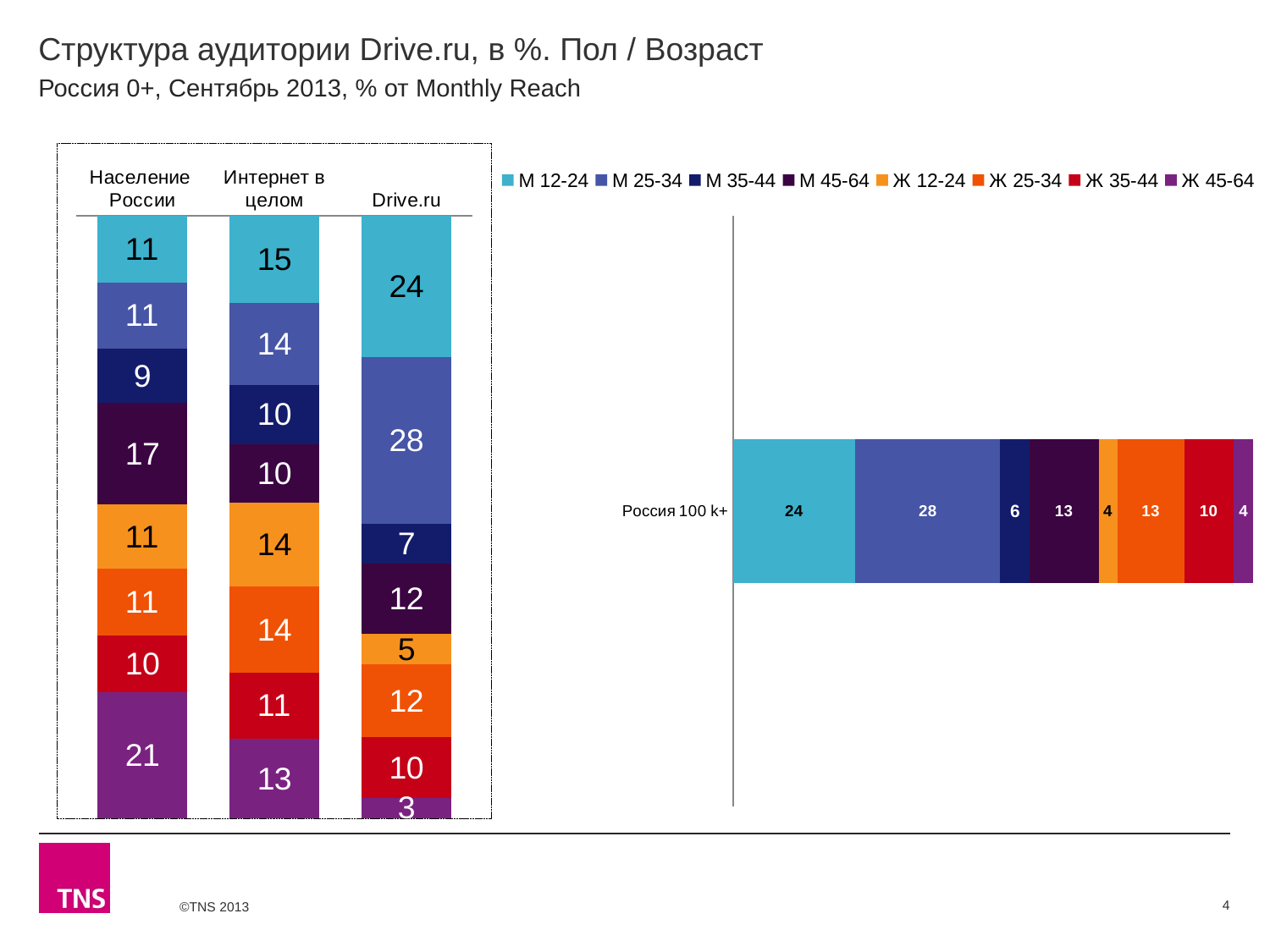
On the left chart, which segment is the largest in the Drive.ru column? М 25-34 How many series does the legend list? 8 What is the title of the slide? Структура аудитории Drive.ru, в %. Пол / Возраст On the left chart, what is the value for Ж 45-64 in the Население России column? 21 On the left chart, which segment is the smallest in the Drive.ru column? Ж 45-64 How many columns (categories) are shown on the left chart? 3 On the left chart, what is the value for М 12-24 in the Интернет в целом column? 15 On the left chart, what is the value for М 25-34 in the Drive.ru column? 28 What kind of chart is the right chart (Россия 100 k+)? Stacked bar chart On the right chart (Россия 100 k+), what is the value for М 35-44? 6 On the left chart, what is the difference between the М 12-24 value for Drive.ru and for Население России? 13 On the right chart (Россия 100 k+), which is larger: Ж 25-34 or Ж 35-44? Ж 25-34